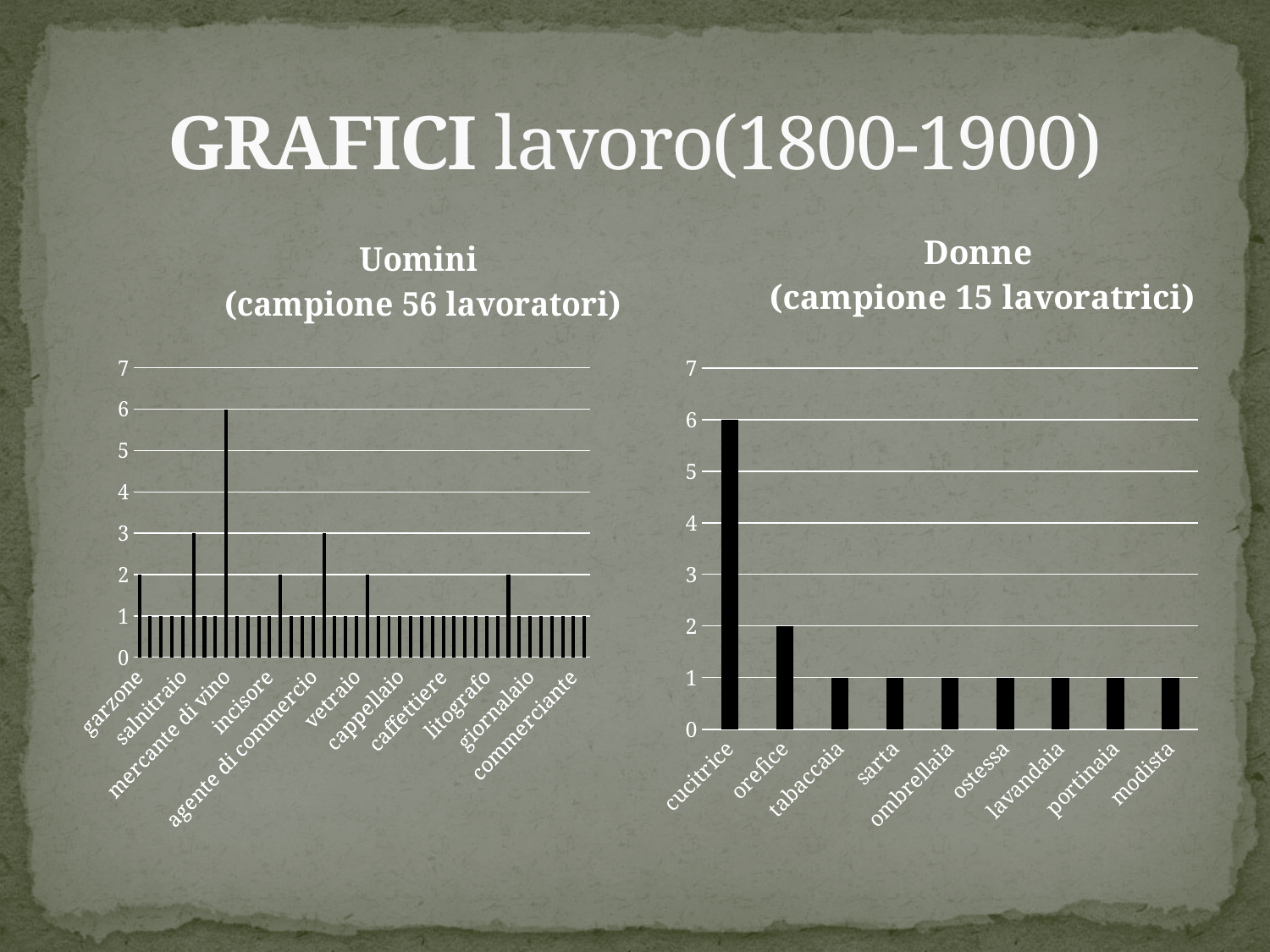
In the Uomini (campione 56 lavoratori) chart, what is the value for garzone? 2 How many categories are shown in the Donne (campione 15 lavoratrici) chart? 9 In the Donne (campione 15 lavoratrici) chart, what is the value for cucitrice? 6 In the Donne (campione 15 lavoratrici) chart, what is the value for sarta? 1 In the Donne (campione 15 lavoratrici) chart, is the value for cucitrice greater or less than 5? greater What kind of chart is the Donne (campione 15 lavoratrici) chart? bar chart In the Donne (campione 15 lavoratrici) chart, what is the difference between the values for cucitrice and orefice? 4 In the Donne (campione 15 lavoratrici) chart, what is the value for orefice? 2 What is the title of the chart on the left of the slide? Uomini (campione 56 lavoratori) In the Uomini (campione 56 lavoratori) chart, what is the highest value reached by any bar? 6 In the Donne (campione 15 lavoratrici) chart, which category has the highest value? cucitrice In the Donne (campione 15 lavoratrici) chart, which is larger, the value for orefice or the value for modista? orefice